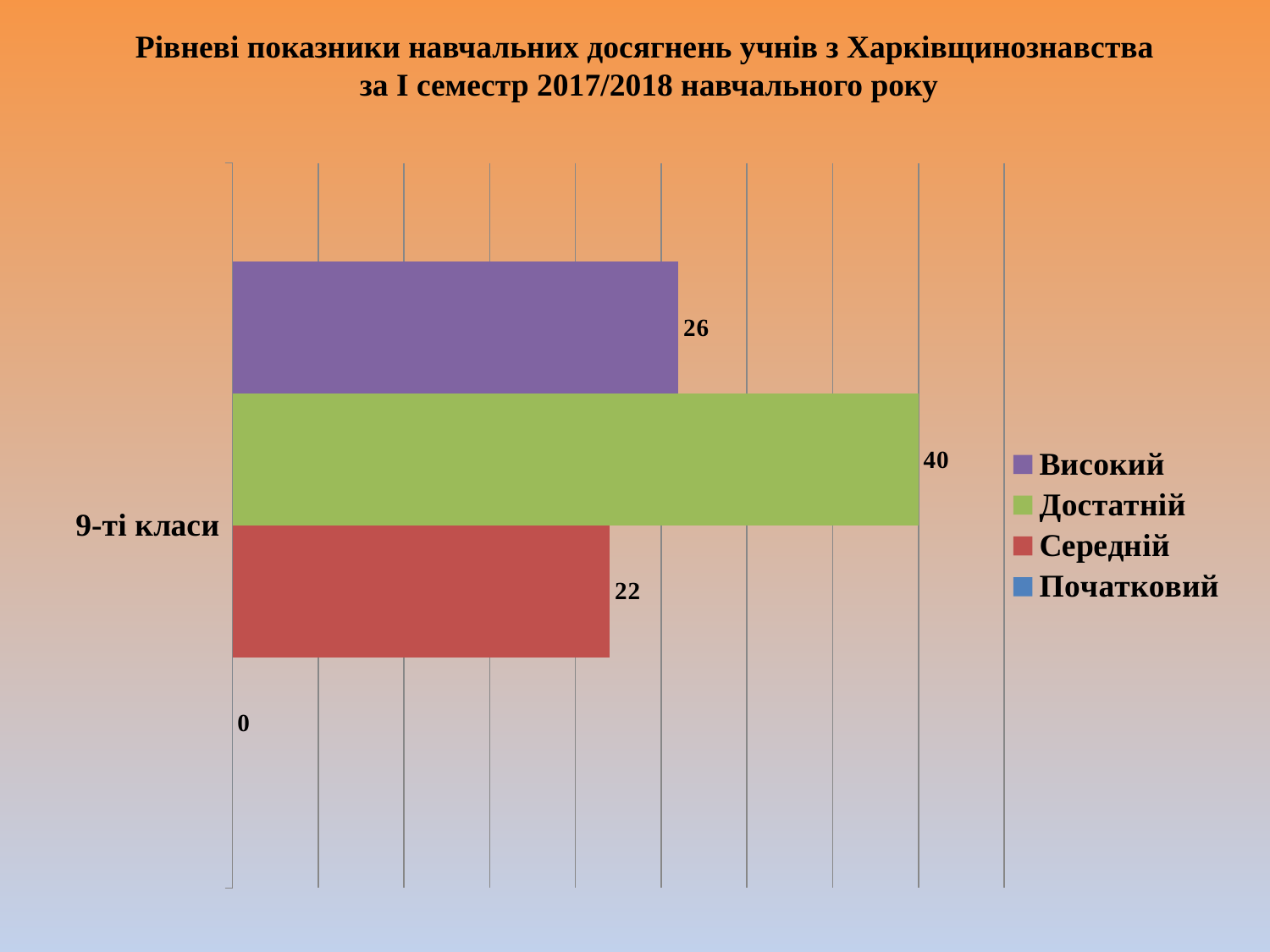
What is the difference between the Високий and Середній values for 9-ті класи? 4 What is the value for Середній for 9-ті класи? 22 What is the difference between the Достатній and Високий values for 9-ті класи? 14 How many series does the legend list? 4 What is the value for Високий for 9-ті класи? 26 What colour is the bar for Достатній? Green Which series has the lowest value for 9-ті класи? Початковий What is the value for Достатній for 9-ті класи? 40 Which is larger for 9-ті класи, Високий or Середній? Високий Which series has the highest value for 9-ті класи? Достатній What is the value for Початковий for 9-ті класи? 0 What kind of chart is shown on the slide? Bar chart